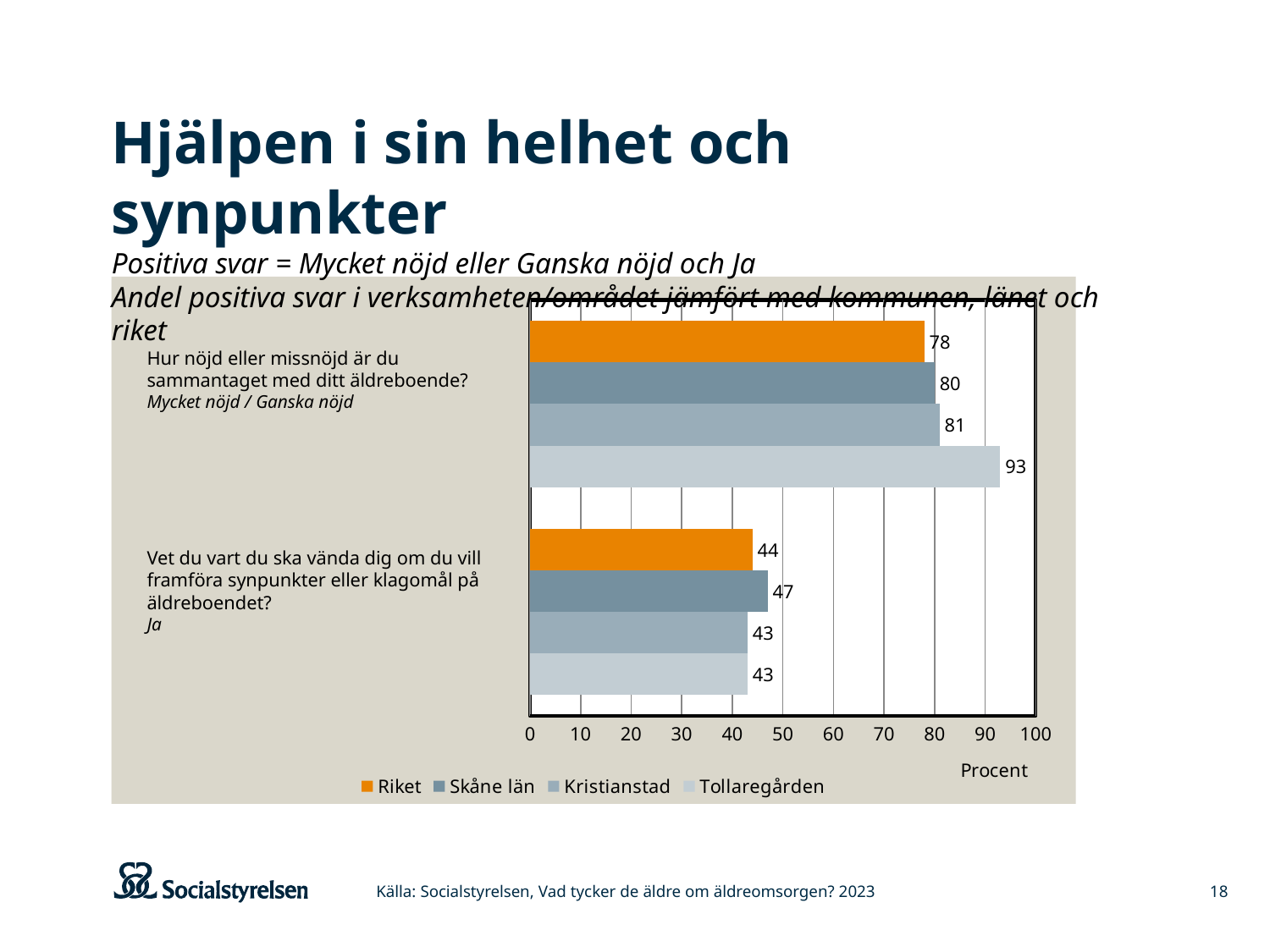
How many series does the legend list? 4 Which series has the highest value for the question "Hur nöjd eller missnöjd är du sammantaget med ditt äldreboende?"? Tollaregården What is the difference between Skåne län and Kristianstad for the question "Vet du vart du ska vända dig om du vill framföra synpunkter eller klagomål på äldreboendet?"? 4 What kind of chart is shown on the slide? Bar chart What value does Skåne län have for the question "Hur nöjd eller missnöjd är du sammantaget med ditt äldreboende?"? 80 What value does Riket have for the question "Vet du vart du ska vända dig om du vill framföra synpunkter eller klagomål på äldreboendet?"? 44 Which series has the lowest value for the question "Hur nöjd eller missnöjd är du sammantaget med ditt äldreboende?"? Riket Which is larger for the question "Hur nöjd eller missnöjd är du sammantaget med ditt äldreboende?": Kristianstad or Riket? Kristianstad Which series has the highest value for the question "Vet du vart du ska vända dig om du vill framföra synpunkter eller klagomål på äldreboendet?"? Skåne län What value does Tollaregården have for the question "Hur nöjd eller missnöjd är du sammantaget med ditt äldreboende?"? 93 Which colour represents Riket in the chart? Orange What is the difference between Tollaregården and Riket for the question "Hur nöjd eller missnöjd är du sammantaget med ditt äldreboende?"? 15